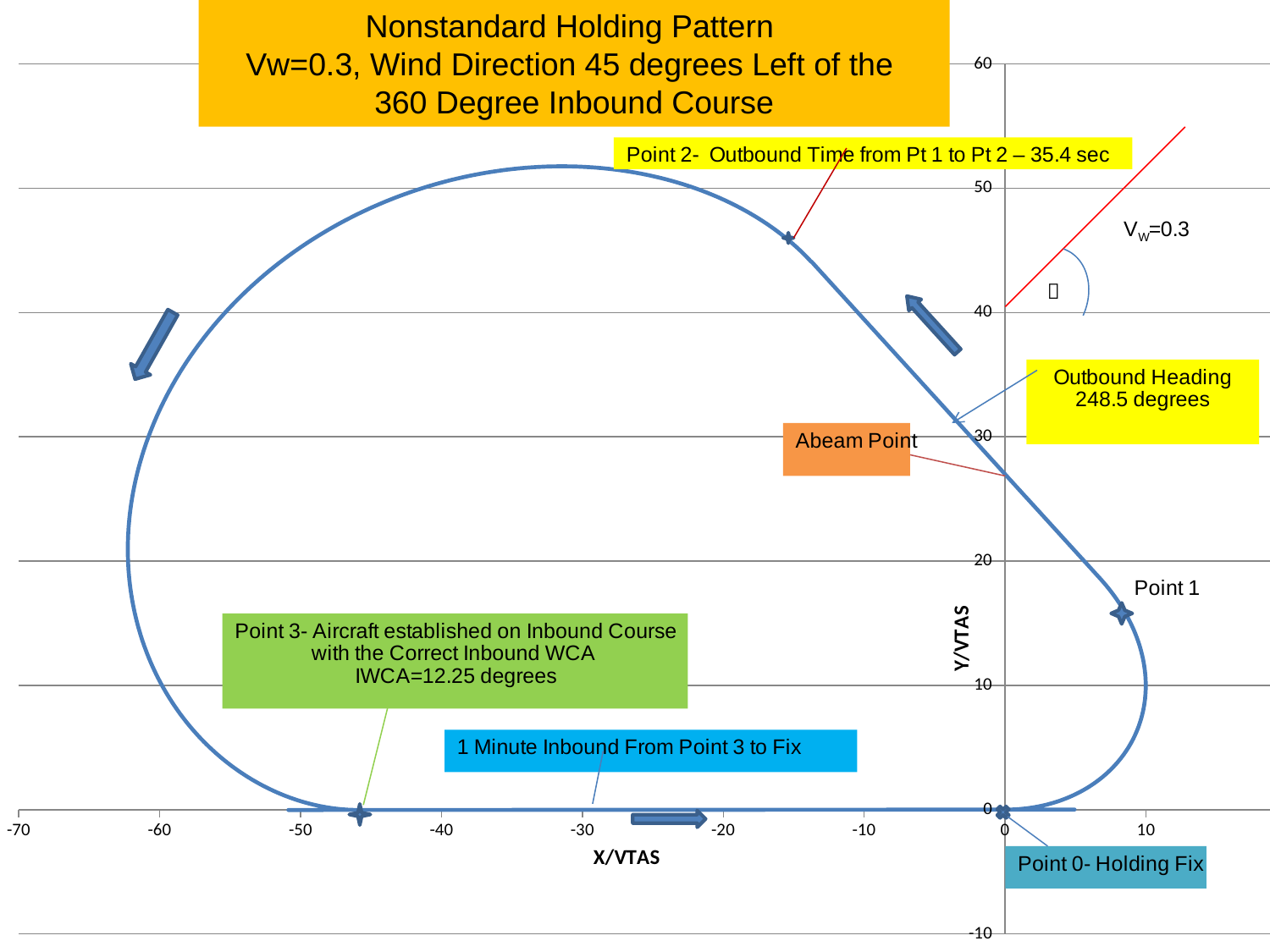
What is the Y/VTAS value of Point 3? 0 Is the X/VTAS value of Point 3 greater or less than -40? less Is the Y/VTAS value of Point 1 greater or less than 10? greater What is the label of the horizontal axis? X/VTAS Which has the larger Y/VTAS value, Point 1 or Point 2? Point 2 What kind of chart is shown on the slide? line chart What is the outbound time from Point 1 to Point 2 according to the annotation? 35.4 sec What is the Y/VTAS value of Point 0, the Holding Fix? 0 Is the Y/VTAS value of Point 2 greater or less than 40? greater What is the label of the vertical axis? Y/VTAS What is the X/VTAS value of Point 0, the Holding Fix? 0